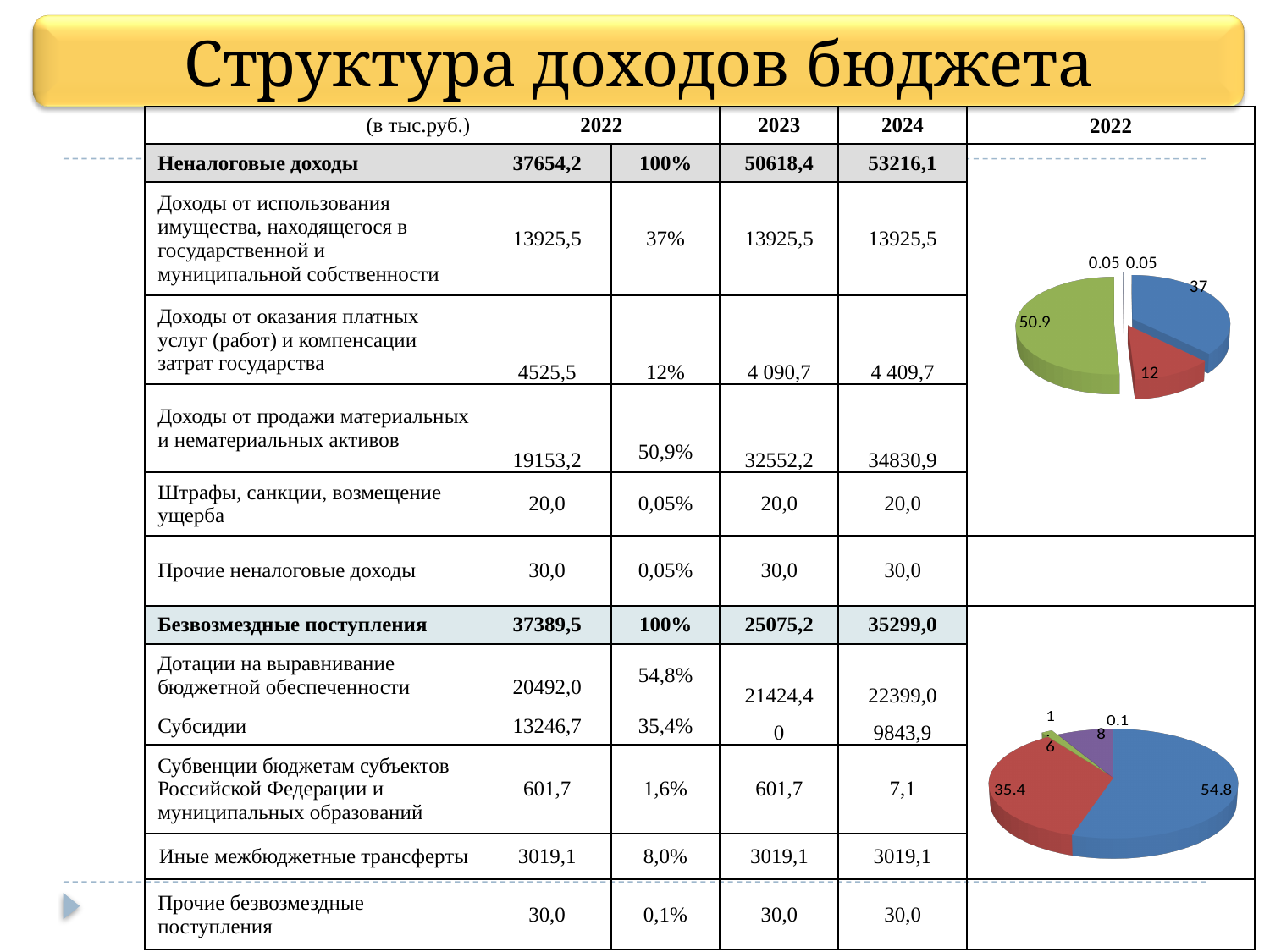
What value is labelled on the red slice of the top pie chart? 12 What colour is the largest slice in the top pie chart? green What kind of chart is the top chart on the right of the slide? pie chart In the bottom pie chart, what is the difference between the blue slice's value (54.8) and the red slice's value (35.4)? 19.4 What value is labelled on the blue slice of the top pie chart? 37 How many slices does the top pie chart have? 5 What is the smallest value labelled on the top pie chart? 0.05 In the top pie chart, what is the difference between the green slice's value (50.9) and the blue slice's value (37)? 13.9 What is the largest value labelled on the top pie chart? 50.9 In the top pie chart, which slice is larger, the blue one or the red one? the blue one What value is labelled on the red slice of the bottom pie chart? 35.4 What is the largest value labelled on the bottom pie chart? 54.8